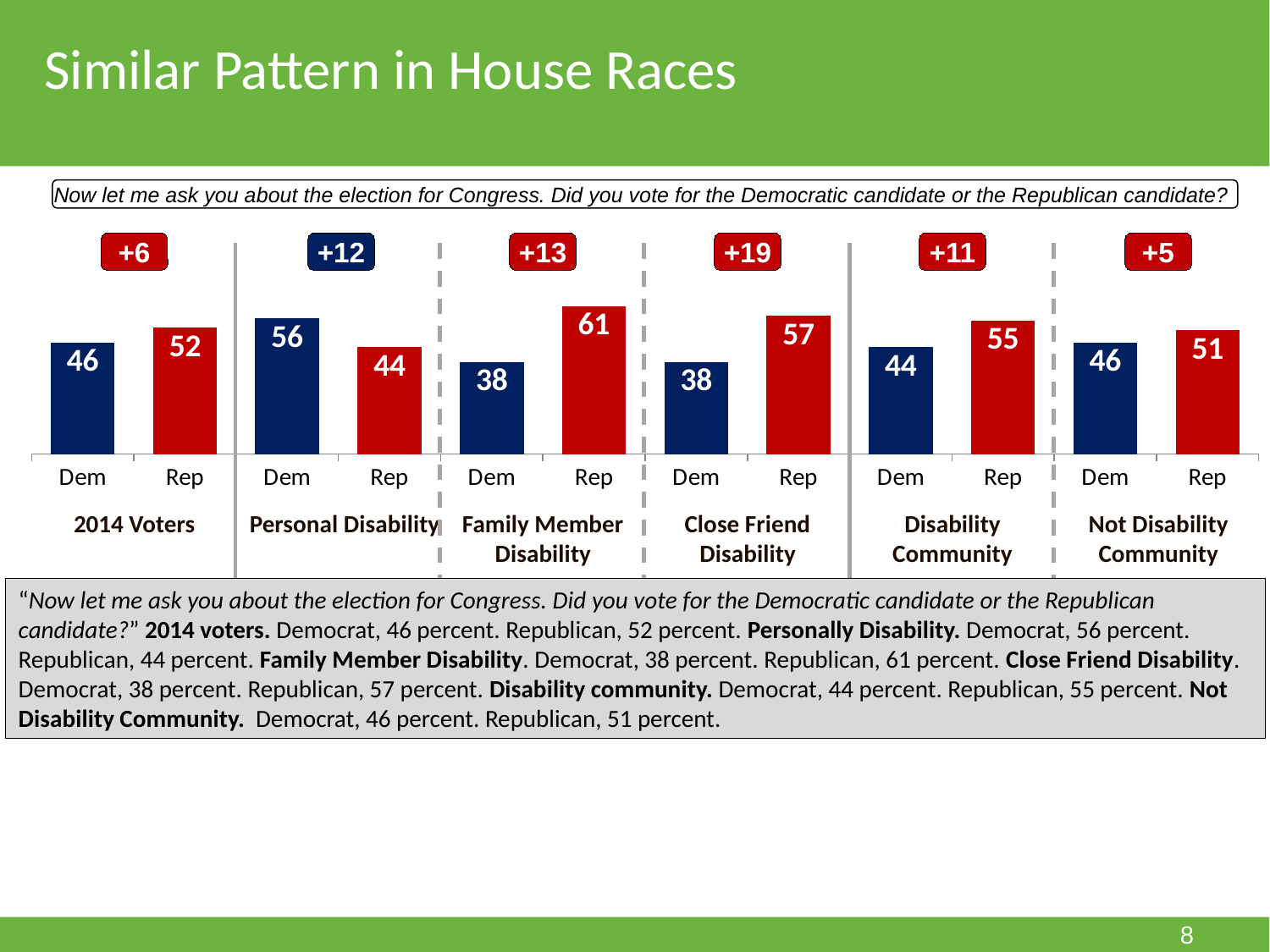
What is the total of Dem and Rep in the Disability Community group? 99 What is the value for Rep in the Family Member Disability group? 61 In the Personal Disability group, which is larger, Dem or Rep? Dem What kind of chart is shown on the slide? Bar chart What is the value for Dem in the Personal Disability group? 56 What margin is shown above the Not Disability Community group? +5 Which group has the lowest Dem value? Family Member Disability and Close Friend Disability (38) What is the value for Dem among 2014 Voters? 46 What is the value for Rep in the Close Friend Disability group? 57 How many groups are shown on the chart? 6 Which bar has the highest value on the chart? Rep, Family Member Disability (61) What is the difference between Rep and Dem in the Close Friend Disability group? 19